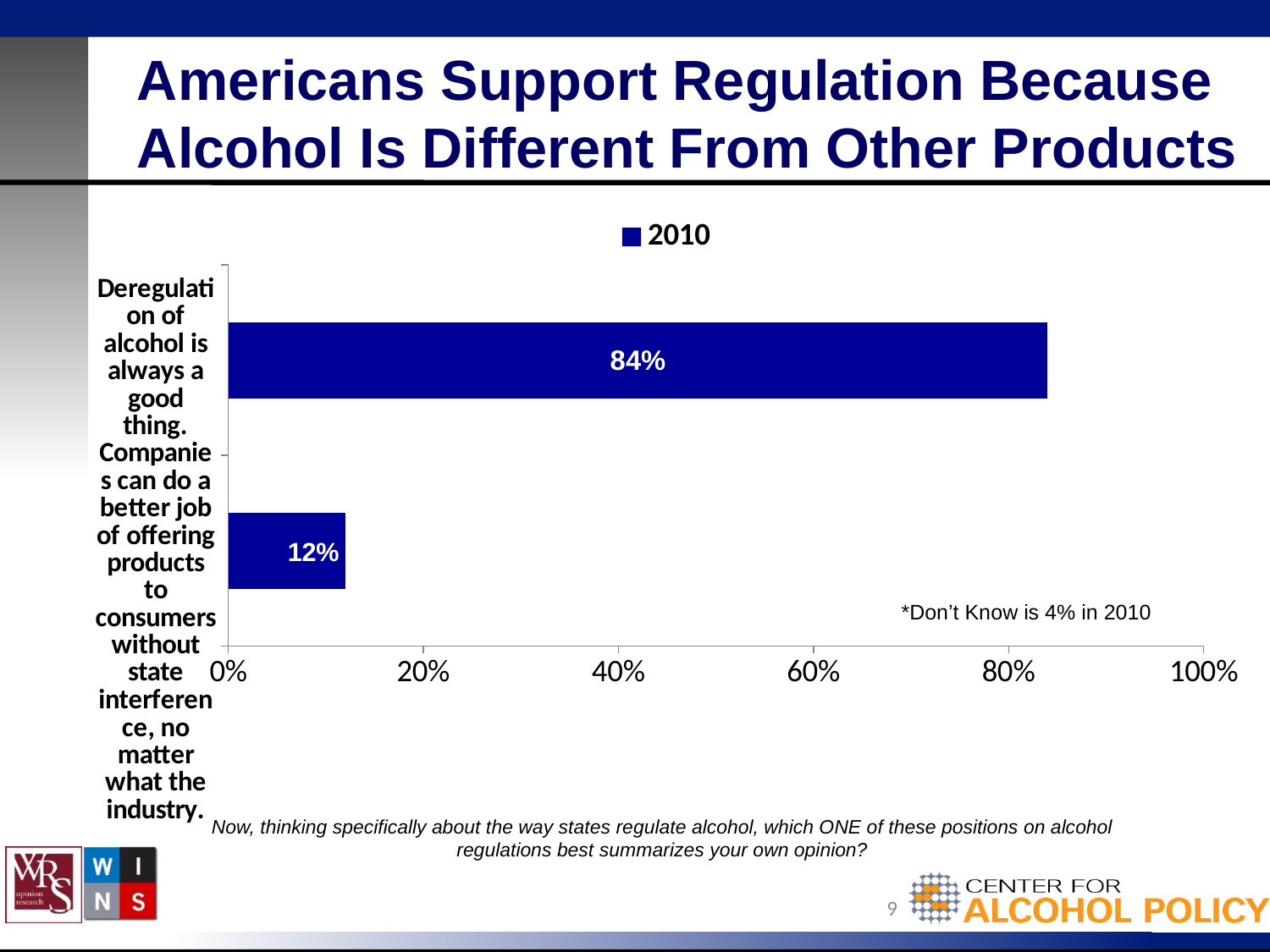
Which bar has the highest value, the top bar or the bottom bar? top bar According to the note on the chart, what percentage is Don't Know in 2010? 4% Is the value of the bottom bar greater or less than 20%? less What kind of chart is shown on the slide? bar chart How many bars are plotted in the chart? 2 How many series does the legend list? 1 Is the value of the top bar greater or less than 80%? greater What is the value of the top bar in the chart? 84% What year does the legend entry show? 2010 What is the difference between the top bar value and the bottom bar value? 72% What is the value of the bottom bar in the chart? 12% Which bar has the lowest value, the top bar or the bottom bar? bottom bar